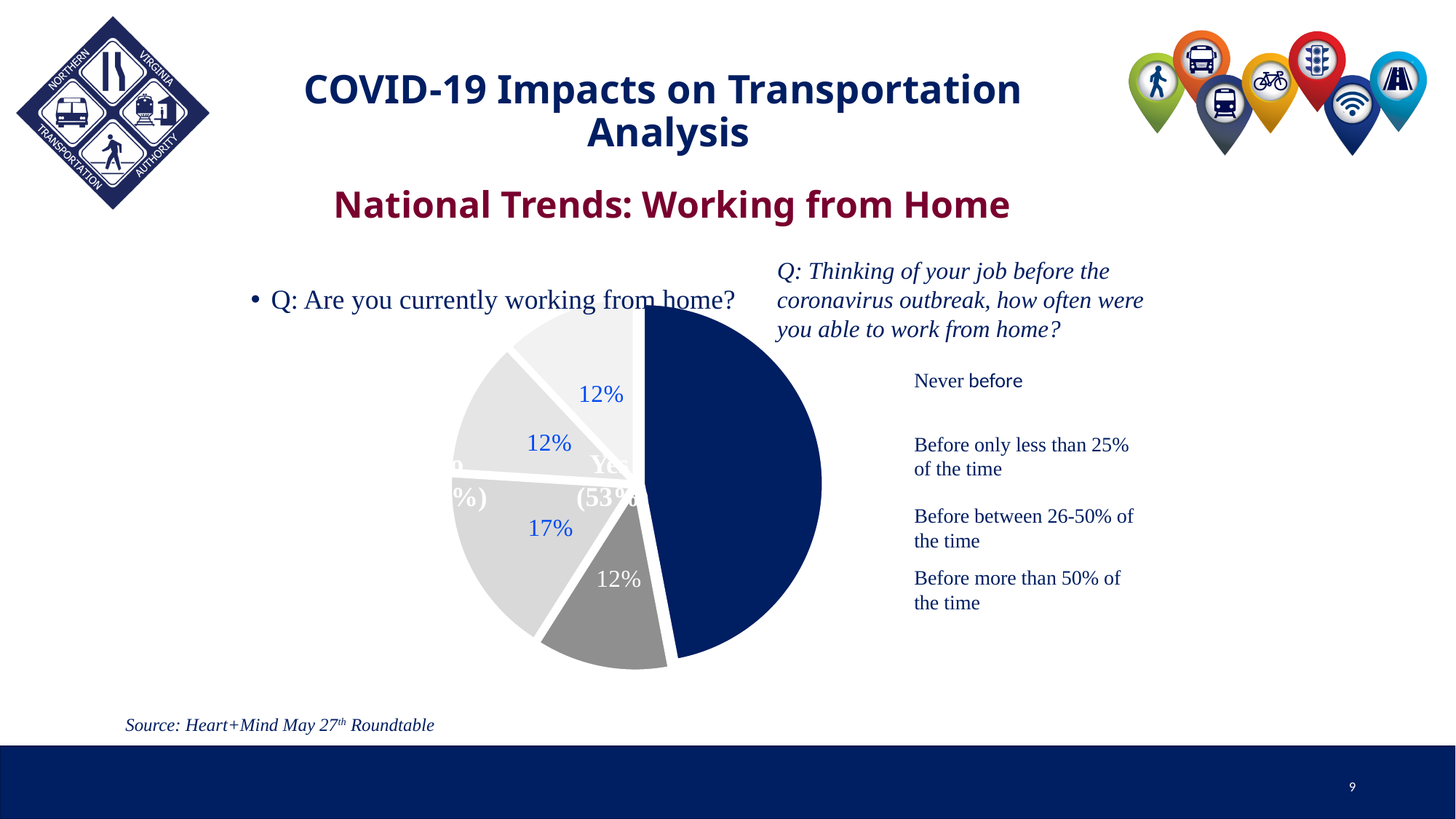
What percentage is shown for the 'Yes' slice of the pie chart? 53% How many slices in the pie chart are labelled 12%? 3 What is the difference between the 17% slice and one of the 12% slices in the pie chart? 5 percentage points What kind of chart is shown on the slide? pie chart What colour is the largest slice of the pie chart? dark blue Is the 'Yes' slice of the pie chart greater or less than 50%? greater How many slices does the pie chart have? 5 What is the value of the dark grey slice of the pie chart? 12% Which slice of the pie chart is the largest? Yes What is the largest value shown among the light grey slices of the pie chart? 17% What survey question does the pie chart answer, as stated in the bullet on the slide? Q: Are you currently working from home? Which is larger in the pie chart: the 17% slice or the dark grey 12% slice? the 17% slice